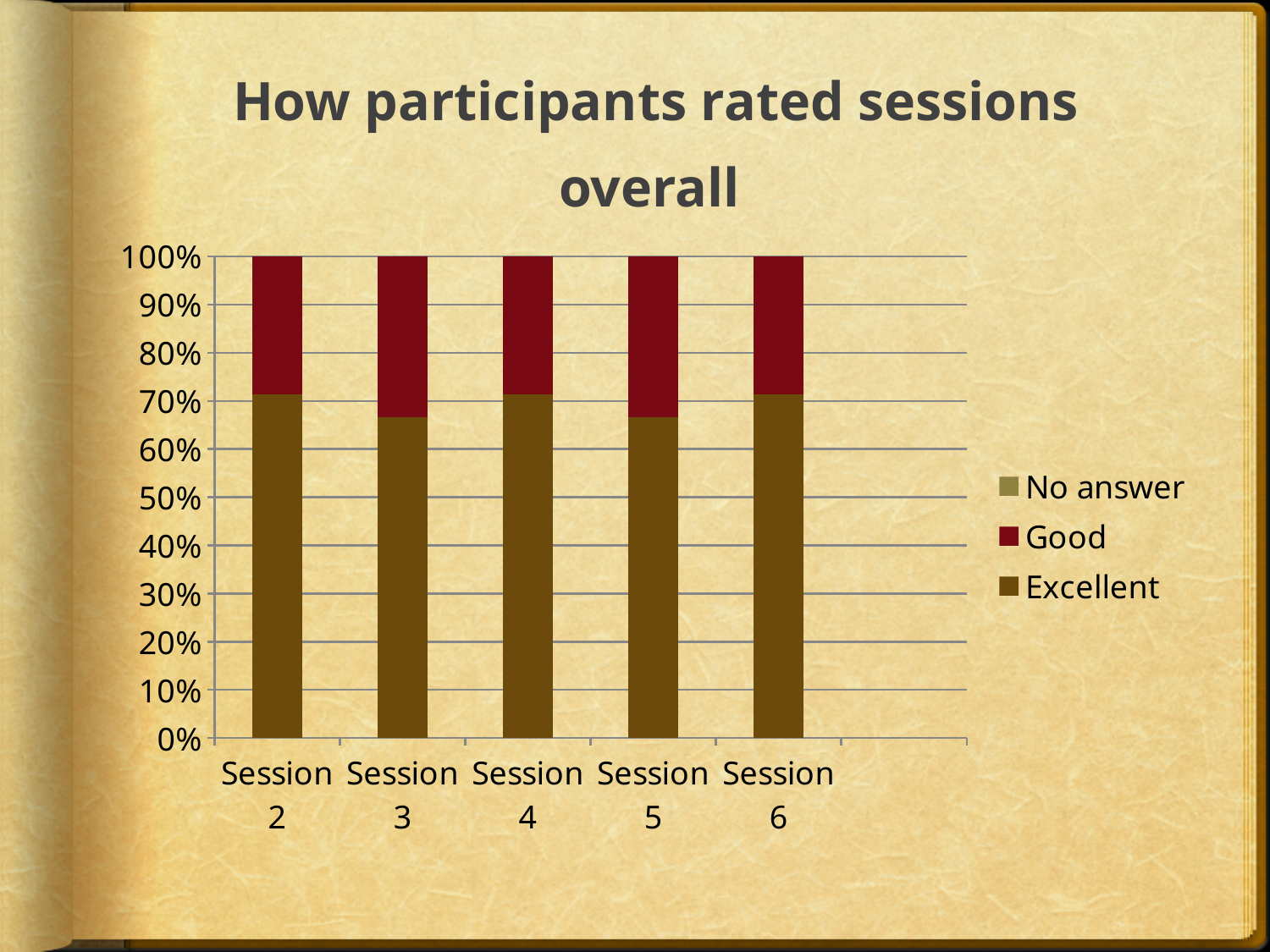
Is the Good value for Session 4 greater or less than 40%? less Which legend entry is shown in dark red? Good Which is larger, the Excellent share for Session 2 or for Session 3? Session 2 What is the total height of the stacked bar for Session 4? 100% Is the Excellent value for Session 2 greater or less than 60%? greater Is the Excellent value for Session 3 greater or less than 70%? less What kind of chart is shown on the slide? bar chart Which is larger, the Good share for Session 5 or for Session 6? Session 5 What is the title of the chart? How participants rated sessions overall How many sessions are shown on the x axis? 5 How many series does the legend list? 3